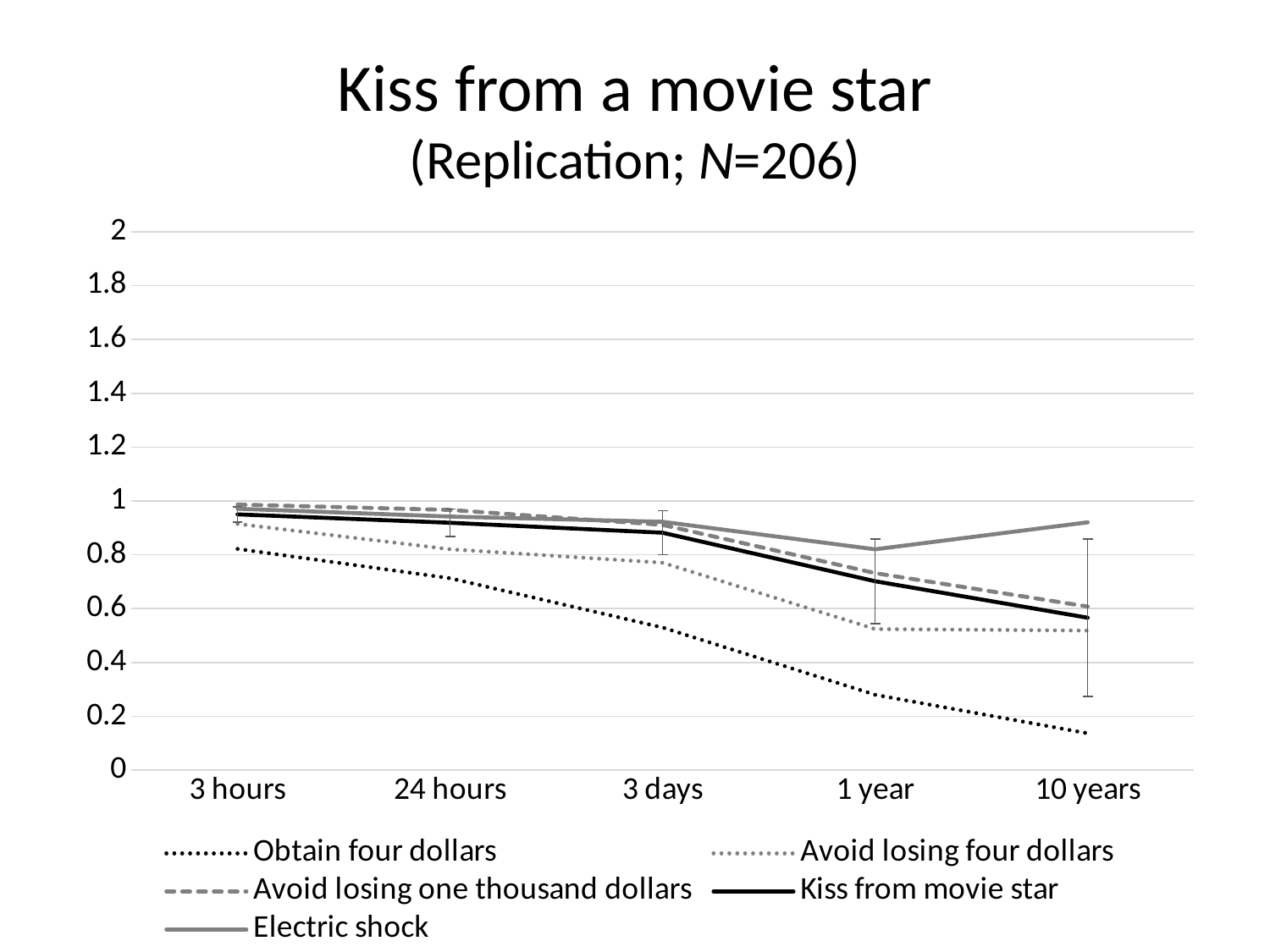
At 1 year, which is larger: Electric shock or Obtain four dollars? Electric shock Is the value for Obtain four dollars at 10 years greater or less than 0.2? less Does the Obtain four dollars series rise or fall from 3 hours to 10 years? fall What is the title of the chart? Kiss from a movie star (Replication; N=206) Which series has the lowest value at 10 years? Obtain four dollars What kind of chart is shown on the slide? line chart How many series does the legend list? 5 How many time points are shown on the x axis? 5 Which series has the lowest value at 3 hours? Obtain four dollars Is the value for Avoid losing four dollars at 10 years greater or less than 0.4? greater Which series has the highest value at 10 years? Electric shock Is the value for Electric shock at 10 years greater or less than 0.8? greater